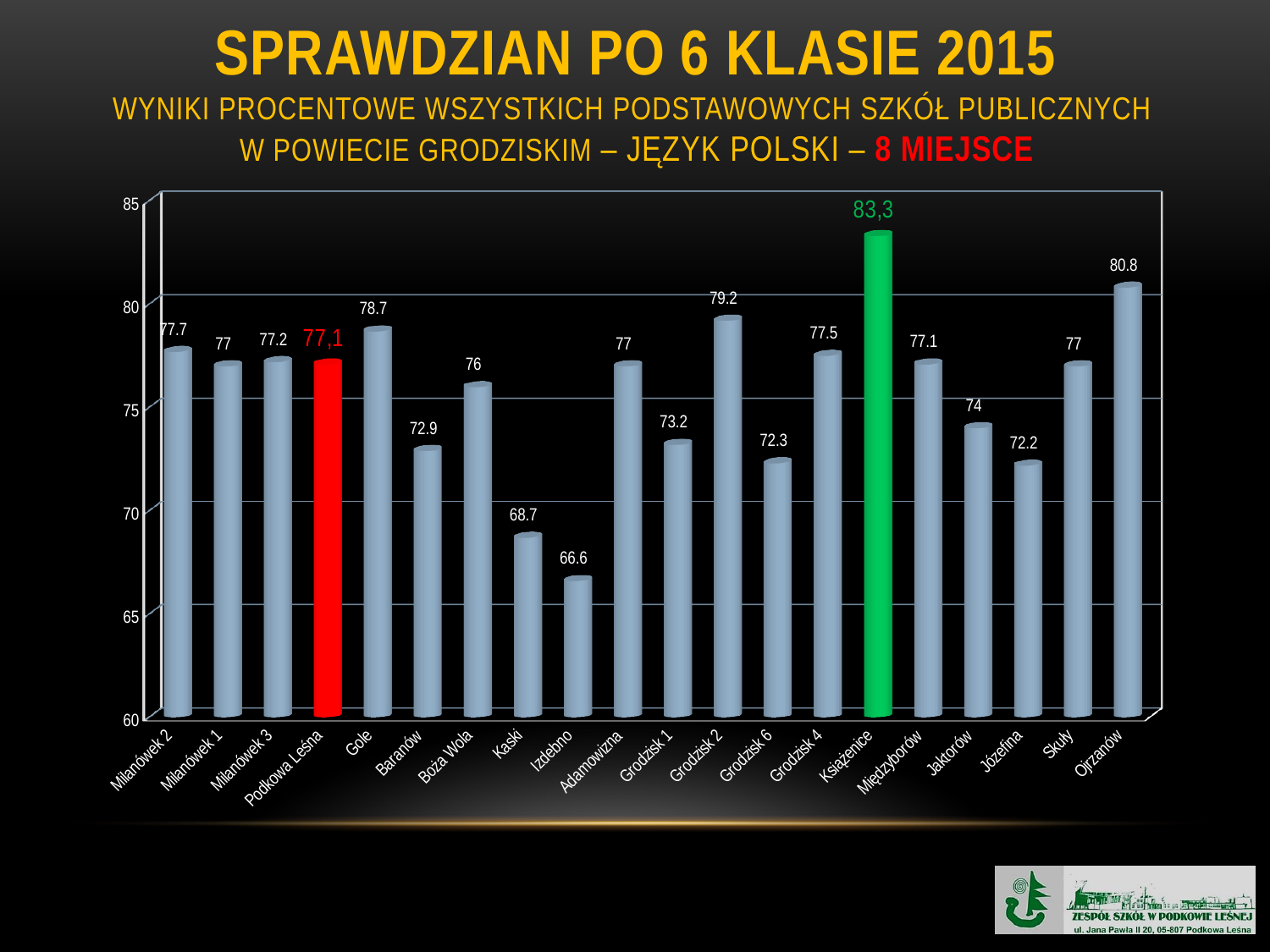
What is the difference between the values for Ojrzanów and Gole? 2.1 Is the value for Kaski greater or less than 70? less What kind of chart is shown on the slide? bar chart What is the value for Gole? 78.7 How many schools are shown on the x axis? 20 What is the value for Podkowa Leśna? 77,1 Which school has the lowest value? Izdebno Which school has the highest value? Książenice What is the value for Jaktorów? 74 What is the difference between the values for Książenice and Izdebno? 16.7 Which is larger, the value for Grodzisk 2 or the value for Grodzisk 1? Grodzisk 2 What colour is the bar for Podkowa Leśna? red